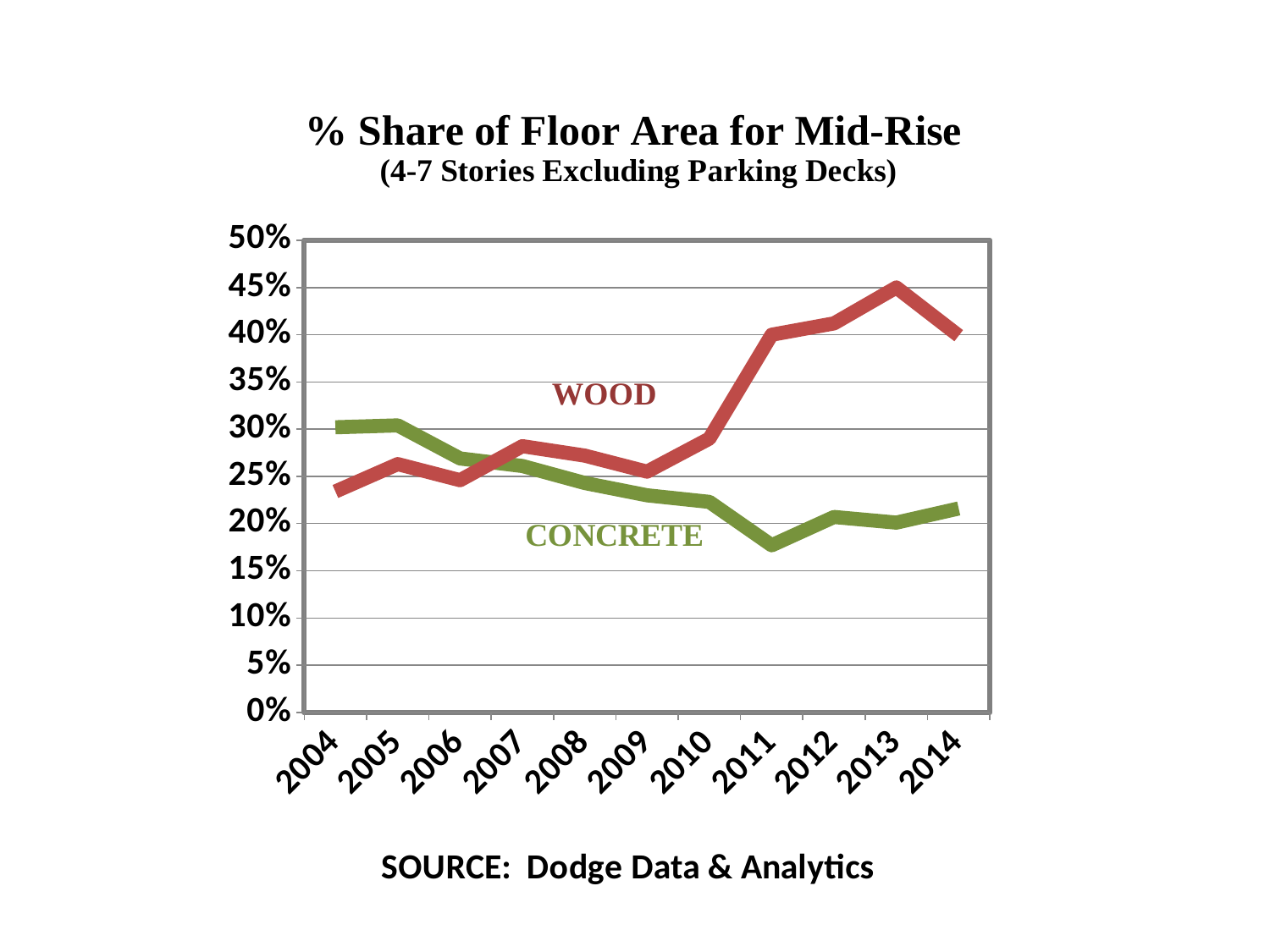
Is the WOOD value for 2013 greater or less than 40%? greater What is the source cited below the chart? Dodge Data & Analytics In which year does the WOOD series reach its highest value? 2013 In 2004, which series has the larger share, WOOD or CONCRETE? CONCRETE Is the WOOD value for 2004 greater or less than 25%? less In 2014, which series has the larger share, WOOD or CONCRETE? WOOD What kind of chart is shown on the slide? line chart How many series are plotted on the chart? 2 In which year does the CONCRETE series reach its lowest value? 2011 How many years are plotted along the x axis? 11 Is the CONCRETE value for 2011 greater or less than 20%? less Does the CONCRETE series generally rise or fall from 2005 to 2011? fall